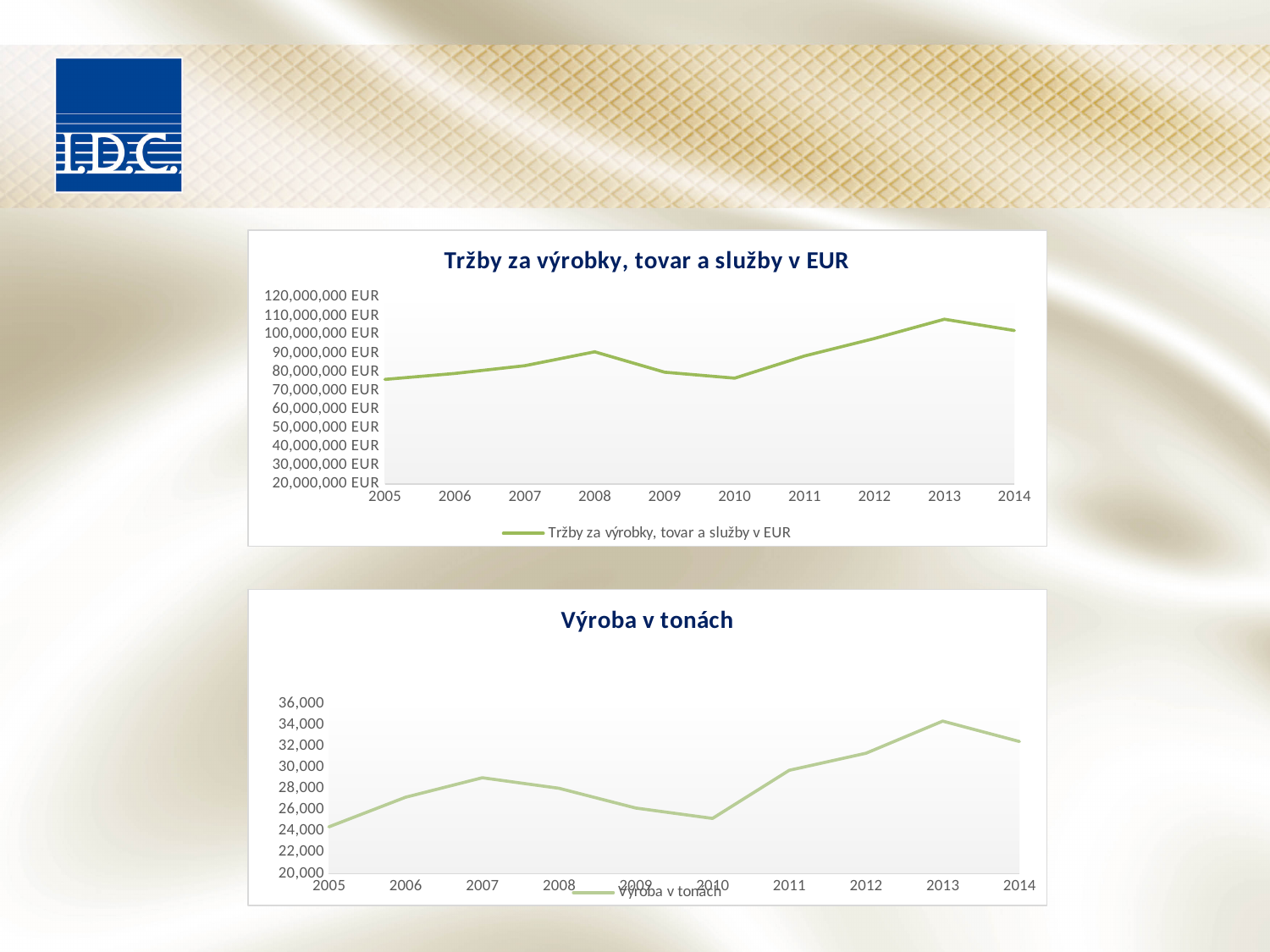
In the bottom chart "Výroba v tonách", which year has the highest value? 2013 In the top chart "Tržby za výrobky, tovar a služby v EUR", is the value for 2013 greater or less than 100,000,000 EUR? greater What kind of chart is the bottom chart titled "Výroba v tonách"? line chart In the bottom chart "Výroba v tonách", which year has the larger value, 2007 or 2010? 2007 In the top chart "Tržby za výrobky, tovar a služby v EUR", which year has the highest value? 2013 How many series does the legend of the bottom chart "Výroba v tonách" list? 1 In the top chart "Tržby za výrobky, tovar a služby v EUR", do the values rise or fall from 2010 to 2013? rise What kind of chart is the top chart titled "Tržby za výrobky, tovar a služby v EUR"? line chart In the top chart "Tržby za výrobky, tovar a služby v EUR", which year has the larger value, 2008 or 2010? 2008 In the bottom chart "Výroba v tonách", is the value for 2005 greater or less than 26,000? less In the top chart "Tržby za výrobky, tovar a služby v EUR", is the value for 2005 greater or less than 80,000,000 EUR? less In the top chart "Tržby za výrobky, tovar a služby v EUR", how many years are plotted on the x axis? 10